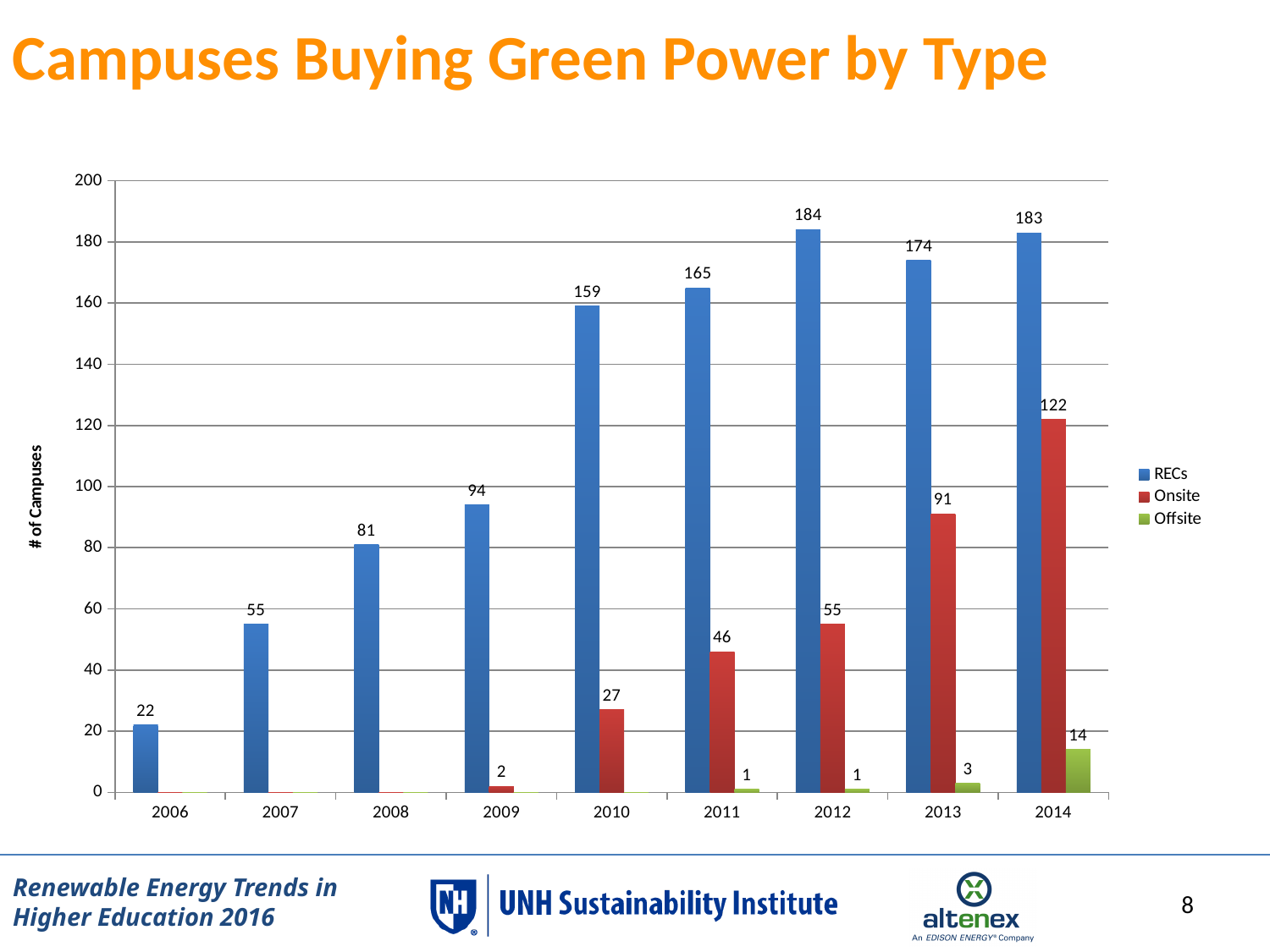
How many series does the legend list? 3 What kind of chart is shown on the slide? Bar chart Do the RECs values rise or fall from 2006 to 2012? Rise What is the Offsite value for 2014? 14 Which is larger in 2014, the RECs value or the Onsite value? RECs What is the Onsite value for 2013? 91 What is the RECs value for 2010? 159 Which year has the lowest RECs value? 2006 What is the label of the y axis? # of Campuses How many years are shown on the x axis? 9 Which year has the highest RECs value? 2012 What is the difference between the RECs value in 2012 and the RECs value in 2013? 10